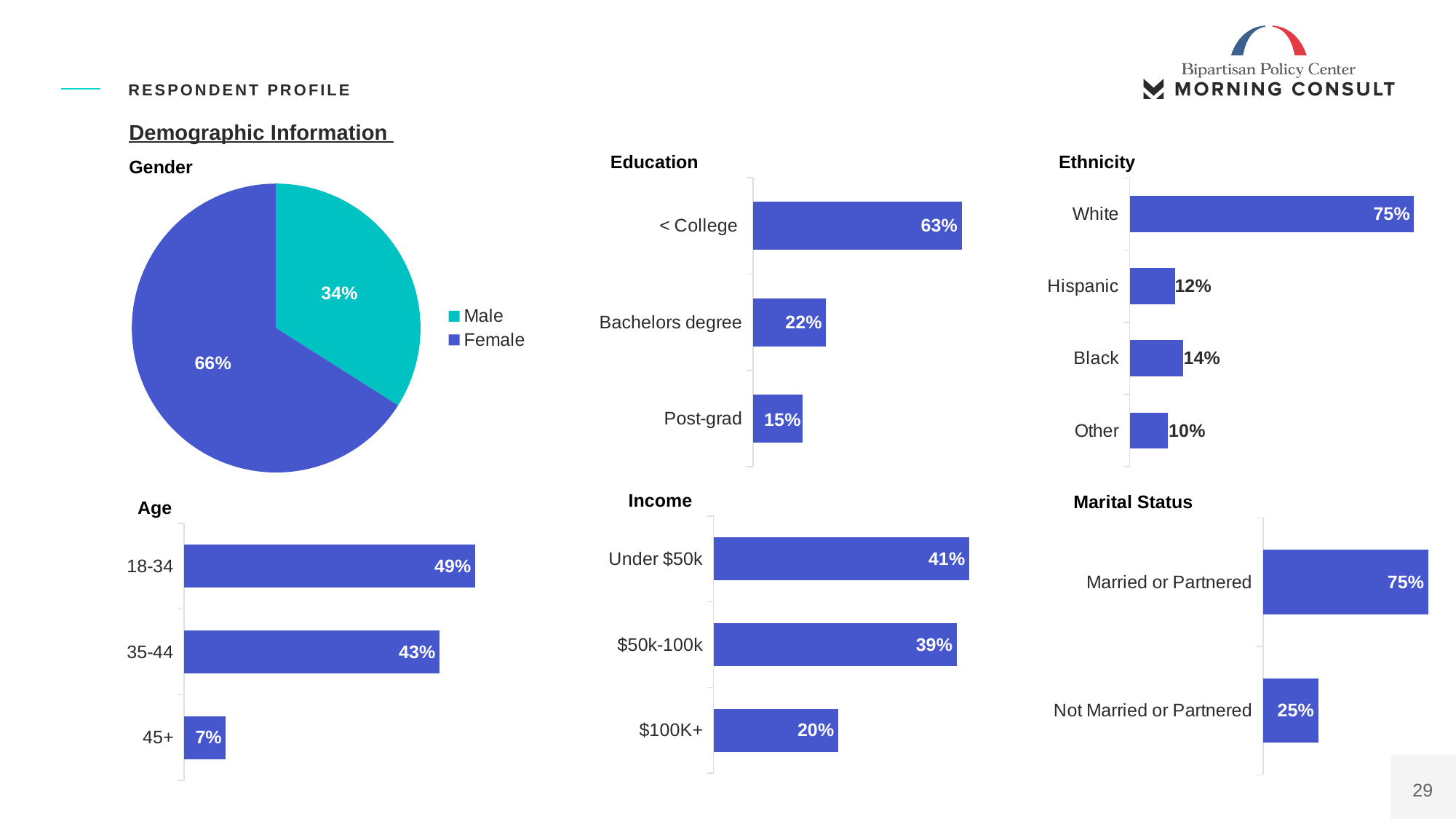
In the Gender chart, what share of respondents are Female? 66% In the Ethnicity chart, what is the difference between the values for White and Black? 61% What kind of chart is the Gender chart? pie chart In the Marital Status chart, what is the difference between Married or Partnered and Not Married or Partnered? 50% How many series does the legend of the Gender chart list? 2 In the Education chart, what is the value for Bachelors degree? 22% In the Ethnicity chart, which category has the lowest value? Other In the Ethnicity chart, what is the value for Hispanic? 12% In the Education chart, which category has the highest value? < College In the Income chart, what is the value for $100K+? 20% In the Age chart, how many categories are shown? 3 In the Age chart, which is larger, the value for 18-34 or the value for 35-44? 18-34